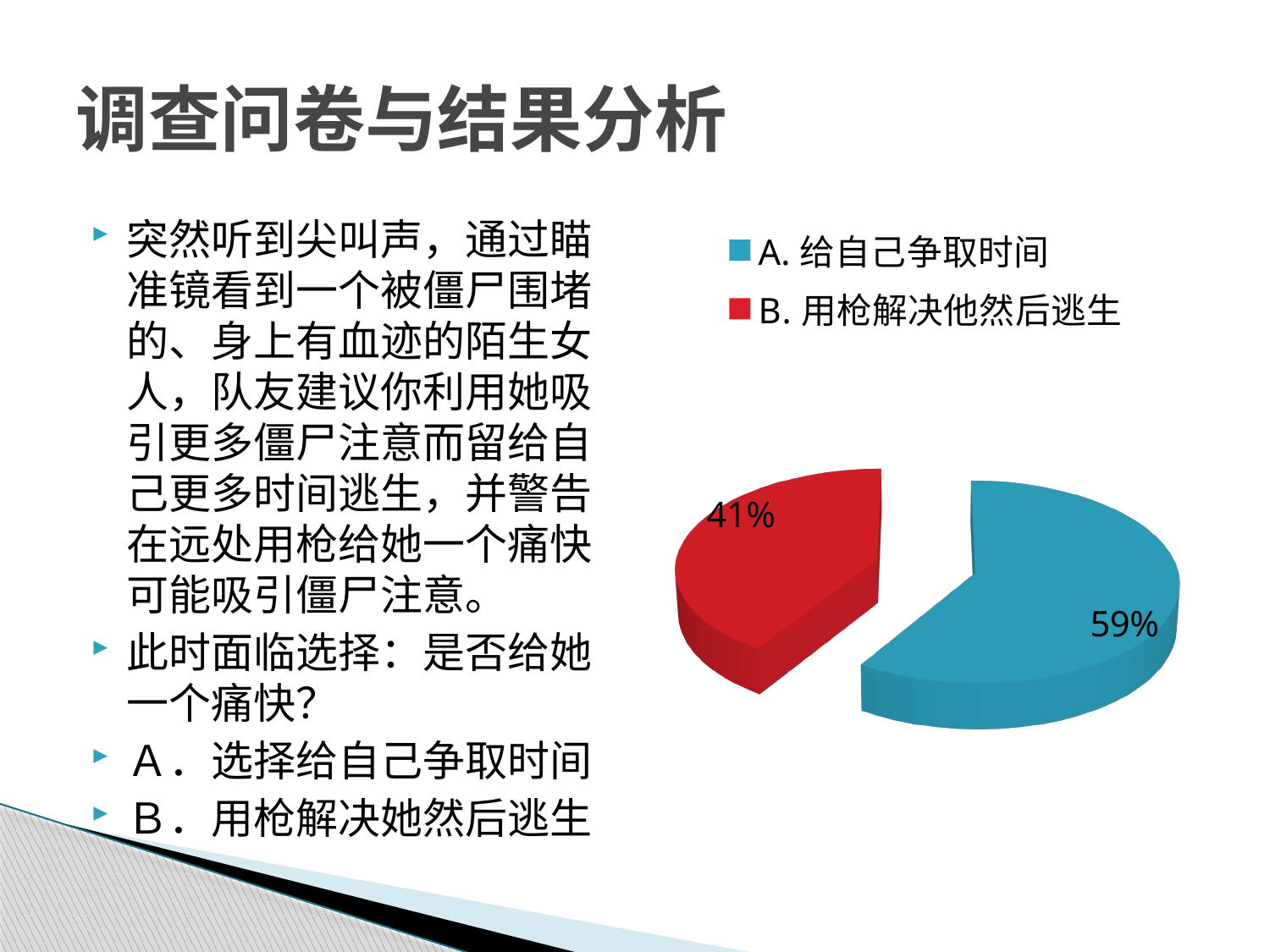
What colour is the slice for "B. 用枪解决他然后逃生"? red Which is larger, the share for "A. 给自己争取时间" or the share for "B. 用枪解决他然后逃生"? A. 给自己争取时间 Which option has the smallest share of the pie? B. 用枪解决他然后逃生 How many slices does the pie chart have? 2 What kind of chart is shown on the slide? pie chart What share of the pie does "A. 给自己争取时间" have? 59% What colour is the slice for "A. 给自己争取时间"? blue How many entries does the legend list? 2 What is the difference in percentage points between the share for A and the share for B? 18% What share of the pie does "B. 用枪解决他然后逃生" have? 41% Which option has the largest share of the pie? A. 给自己争取时间